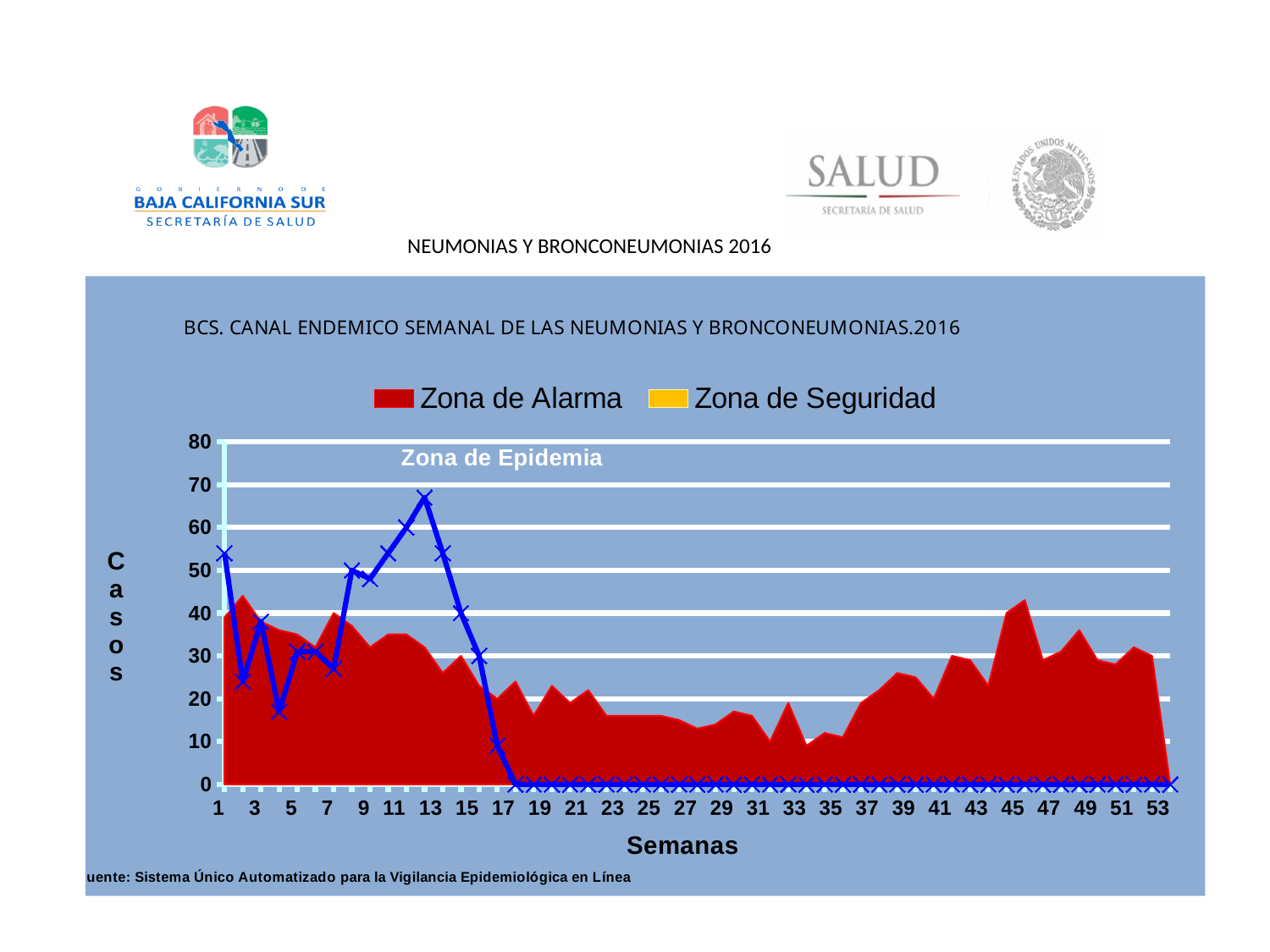
Does the blue line rise or fall between week 13 and week 18? fall What value does the blue line show at week 30? 0 What label is shown on the x axis of the chart? Semanas How many series does the chart legend list? 2 Is the top of the red Zona de Alarma area at week 46 greater or less than 40? less Which is larger on the blue line: the value at week 13 or the value at week 9? week 13 In which week does the blue line of cases reach its highest value? 12 What is the title of the chart? BCS. CANAL ENDEMICO SEMANAL DE LAS NEUMONIAS Y BRONCONEUMONIAS.2016 Is the value of the blue line at week 4 greater or less than 20? less Is the value of the blue line at week 13 greater or less than 60? less